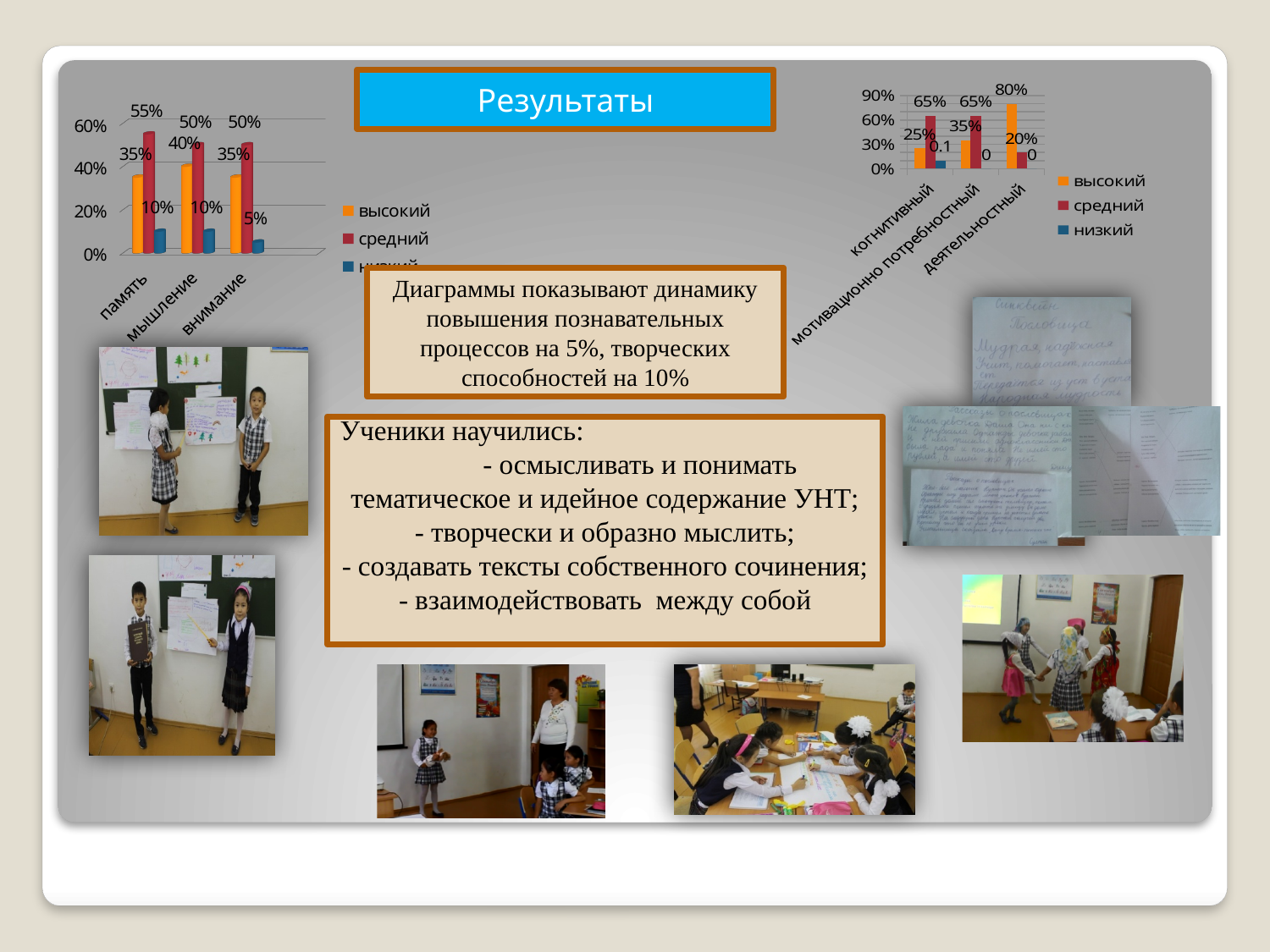
On the right chart, what is the value of высокий for мотивационно потребностный? 35% On the left chart, what is the value of низкий for внимание? 5% On the left chart, what is the difference between the средний and высокий values for память? 20% On the right chart, how many series does the legend list? 3 On the left chart, how many categories are shown on the x axis? 3 On the right chart, which category has the highest высокий value? деятельностный On the right chart, which is larger for деятельностный: высокий or средний? высокий On the right chart, what is the value of высокий for деятельностный? 80% On the right chart, what is the value of средний for когнитивный? 65% On the left chart, what is the value of средний for память? 55% On the left chart, which category has the highest средний value? память On the left chart, what is the value of высокий for мышление? 40%